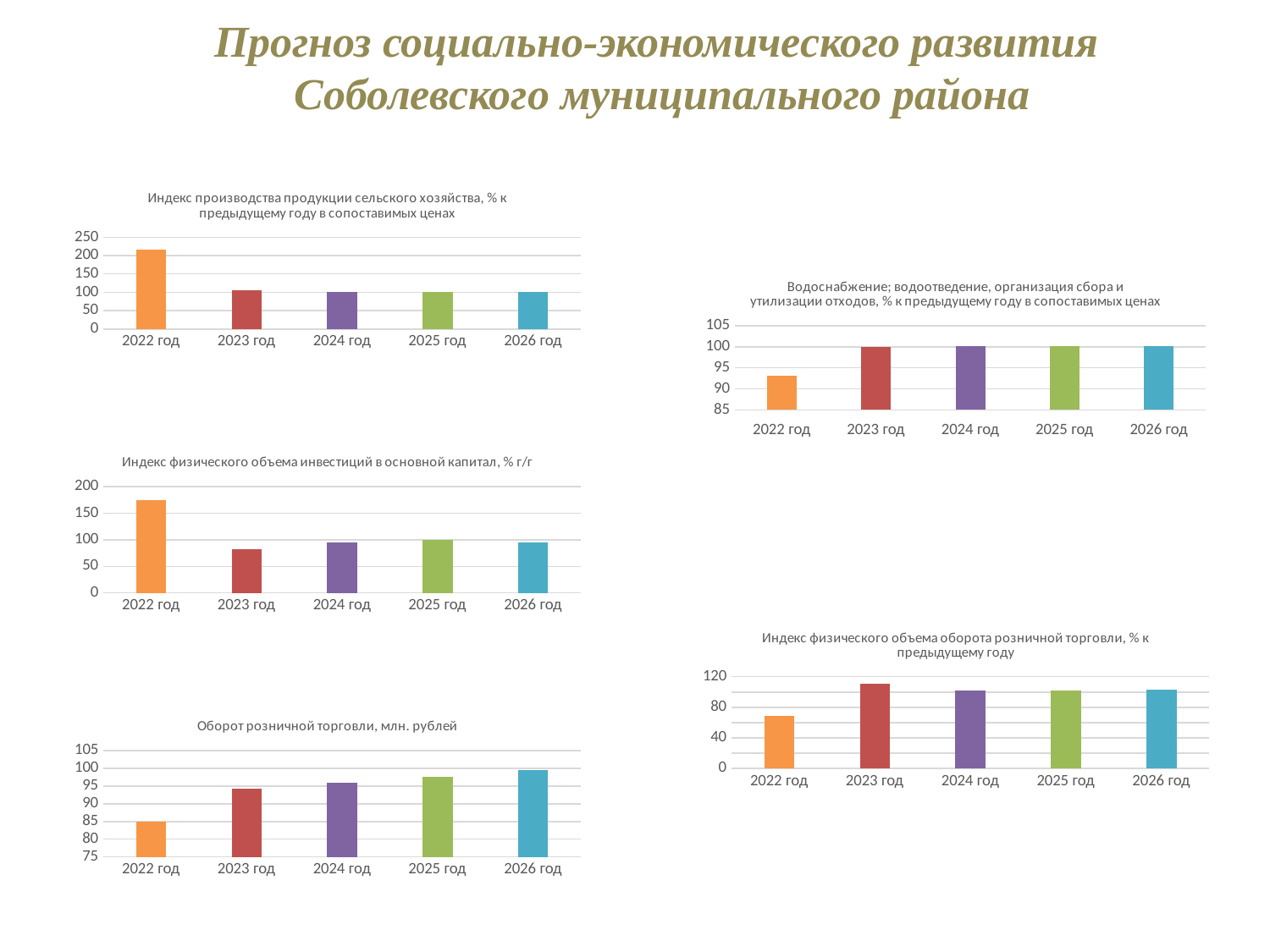
In the chart 'Оборот розничной торговли, млн. рублей', is the value for 2022 год greater or less than 90? less In the chart 'Индекс производства продукции сельского хозяйства, % к предыдущему году в сопоставимых ценах', which year has the highest value? 2022 год In the chart 'Индекс физического объема оборота розничной торговли, % к предыдущему году', which year has the highest value? 2023 год In the chart 'Водоснабжение; водоотведение, организация сбора и утилизации отходов, % к предыдущему году в сопоставимых ценах', which year has the lowest value? 2022 год In the chart 'Индекс физического объема инвестиций в основной капитал, % г/г', which year has the lowest value? 2023 год In the chart 'Водоснабжение; водоотведение, организация сбора и утилизации отходов, % к предыдущему году в сопоставимых ценах', is the value for 2022 год greater or less than 95? less In the chart 'Индекс физического объема инвестиций в основной капитал, % г/г', is the value for 2022 год greater or less than 150? greater In the chart 'Индекс физического объема оборота розничной торговли, % к предыдущему году', which is larger, the value for 2022 год or 2024 год? 2024 год What kind of chart is 'Индекс физического объема инвестиций в основной капитал, % г/г'? bar chart In the chart 'Оборот розничной торговли, млн. рублей', do the values rise or fall from 2022 год to 2026 год? rise How many years are shown on the x axis of the chart 'Оборот розничной торговли, млн. рублей'? 5